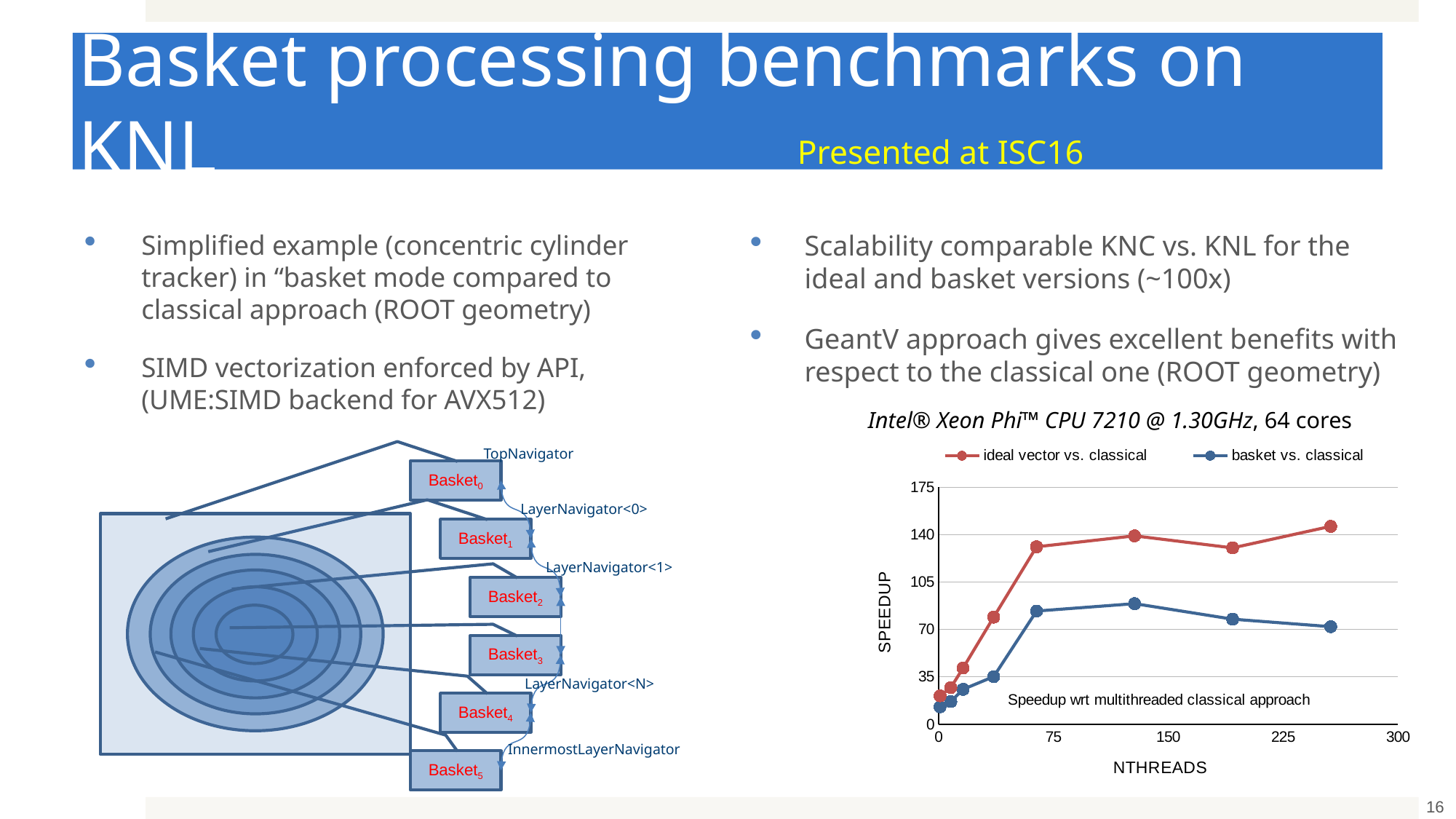
How many data points are plotted for the 'basket vs. classical' series? 8 Does the 'basket vs. classical' speedup rise or fall between about 128 and 256 threads? fall What is the label of the x axis of the speedup chart? NTHREADS Is the speedup of 'basket vs. classical' at about 64 threads greater or less than 105? less What are the two series named in the legend of the speedup chart? ideal vector vs. classical; basket vs. classical At the highest thread count plotted, which series has the larger speedup: 'ideal vector vs. classical' or 'basket vs. classical'? ideal vector vs. classical How many series does the legend of the speedup chart list? 2 Which series reaches the highest speedup in the chart? ideal vector vs. classical What kind of chart is shown on the right side of the slide? line chart Is the speedup of 'ideal vector vs. classical' at about 64 threads greater or less than 105? greater Does the 'ideal vector vs. classical' speedup rise or fall between 0 and about 64 threads? rise Is the speedup of 'basket vs. classical' at about 128 threads greater or less than 70? greater